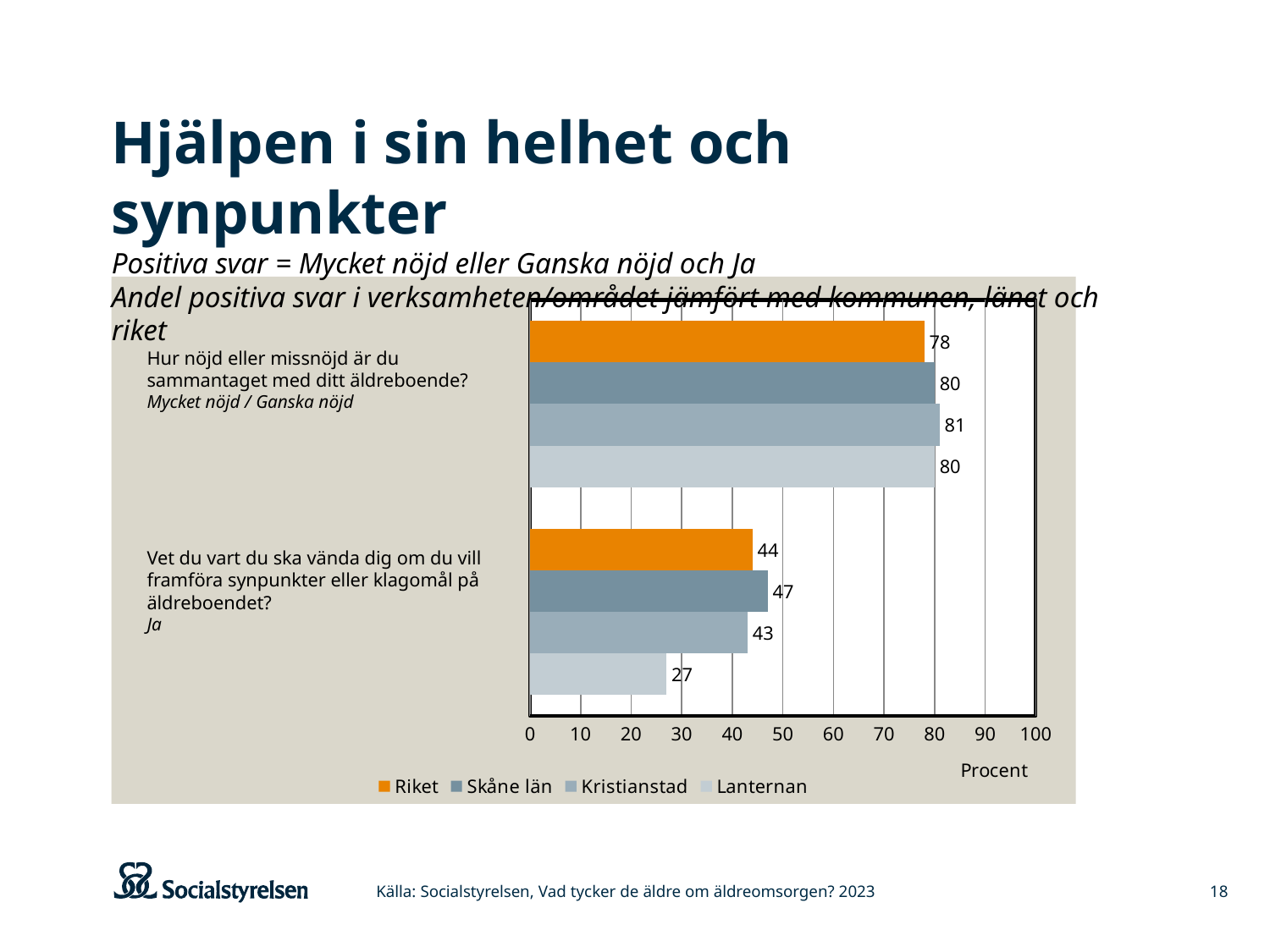
What is the value for Riket on the question about overall satisfaction with the äldreboende (Hur nöjd eller missnöjd är du sammantaget med ditt äldreboende?)? 78 Which series has the highest value on the question about knowing where to turn with synpunkter eller klagomål? Skåne län What is the value for Kristianstad on the question about overall satisfaction with the äldreboende? 81 How many series does the legend list? 4 What is the difference between Skåne län and Lanternan on the question about knowing where to turn with synpunkter eller klagomål? 20 What is the value for Skåne län on the question about knowing where to turn with synpunkter eller klagomål? 47 What is the value for Lanternan on the question about knowing where to turn with synpunkter eller klagomål? 27 What is the difference between Lanternan's value on the overall satisfaction question and its value on the question about knowing where to turn with synpunkter eller klagomål? 53 On the question about overall satisfaction with the äldreboende, which is larger: the value for Riket or the value for Kristianstad? Kristianstad Which series is shown in orange in the legend? Riket What kind of chart is shown on the slide? bar chart Which series has the lowest value on the question about knowing where to turn with synpunkter eller klagomål? Lanternan